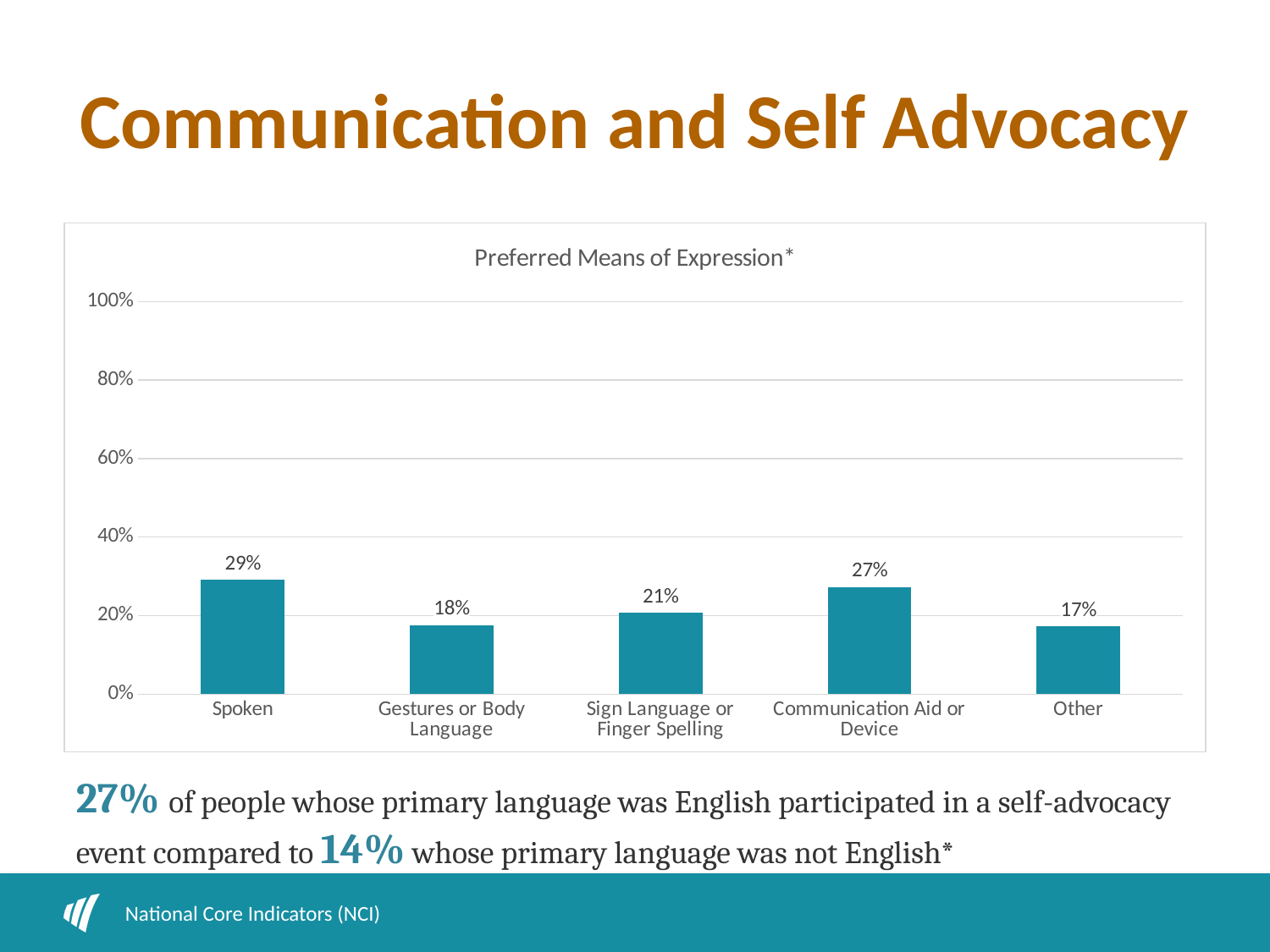
What is the title of the chart? Preferred Means of Expression* Is the value for Spoken greater or less than 40%? less How many categories are shown in the chart? 5 Which is larger, the value for Sign Language or Finger Spelling or the value for Communication Aid or Device? Communication Aid or Device Which category has the lowest value? Other What is the difference between the values for Spoken and Gestures or Body Language? 11% What is the value for Communication Aid or Device? 27% What kind of chart is shown on the slide? bar chart Which category has the highest value? Spoken What is the value for Sign Language or Finger Spelling? 21% What is the value for Spoken in the Preferred Means of Expression chart? 29% What is the value for Other? 17%